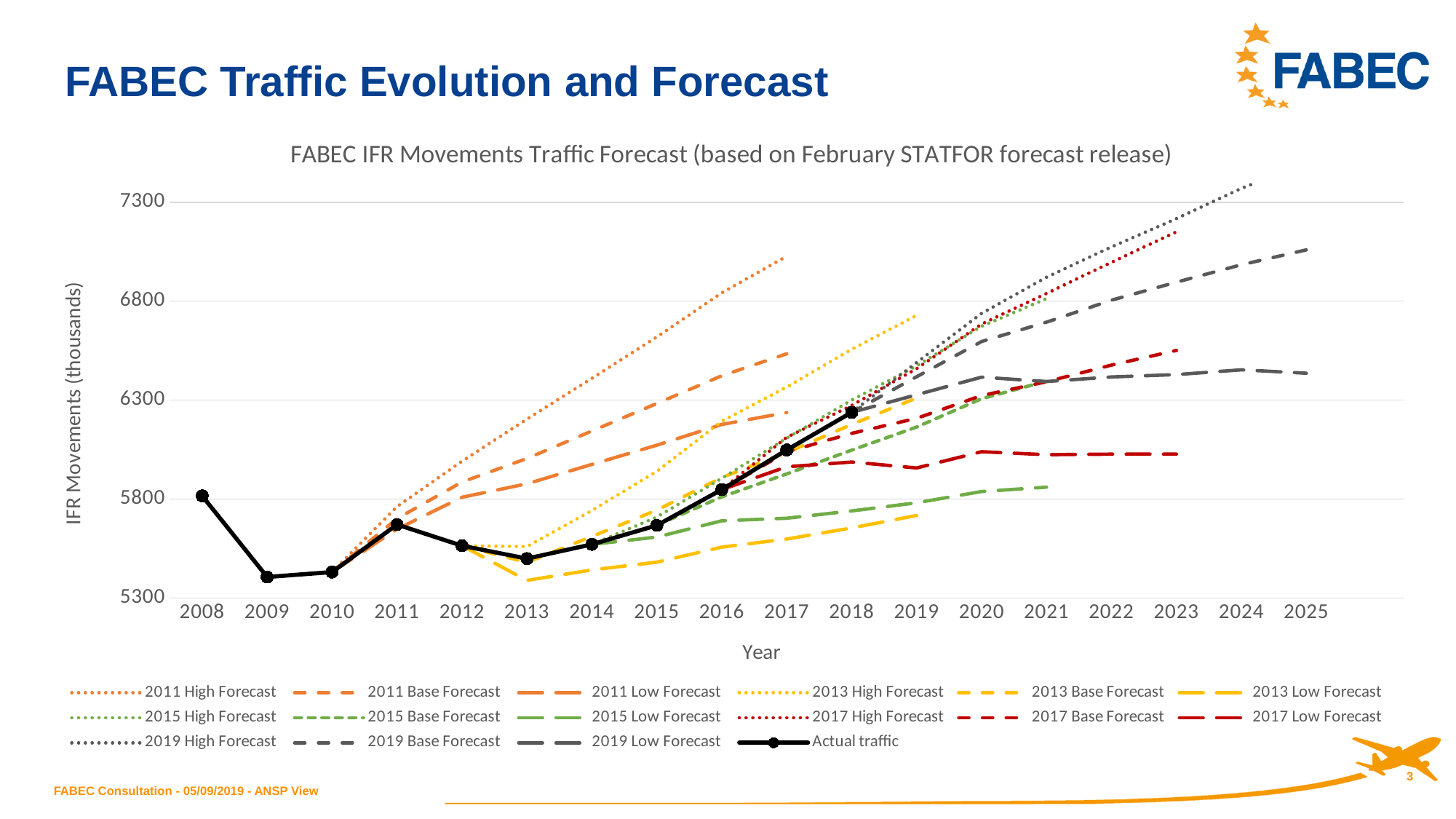
How many years are labelled along the x axis? 18 Does the Actual traffic series rise or fall between 2013 and 2018? Rise In which year is the Actual traffic series at its lowest? 2009 In which year is the Actual traffic series at its highest? 2018 How many series does the legend list? 16 What kind of chart is shown on the slide? Line chart Is the Actual traffic value for 2018 greater or less than 5800? greater Which is larger in 2023: the 2019 Base Forecast or the 2017 Low Forecast? 2019 Base Forecast Is the Actual traffic value for 2009 greater or less than 5800? less What is the label of the vertical axis? IFR Movements (thousands) Is the 2019 High Forecast value for 2024 greater or less than 7300? greater What is the title of the chart? FABEC IFR Movements Traffic Forecast (based on February STATFOR forecast release)